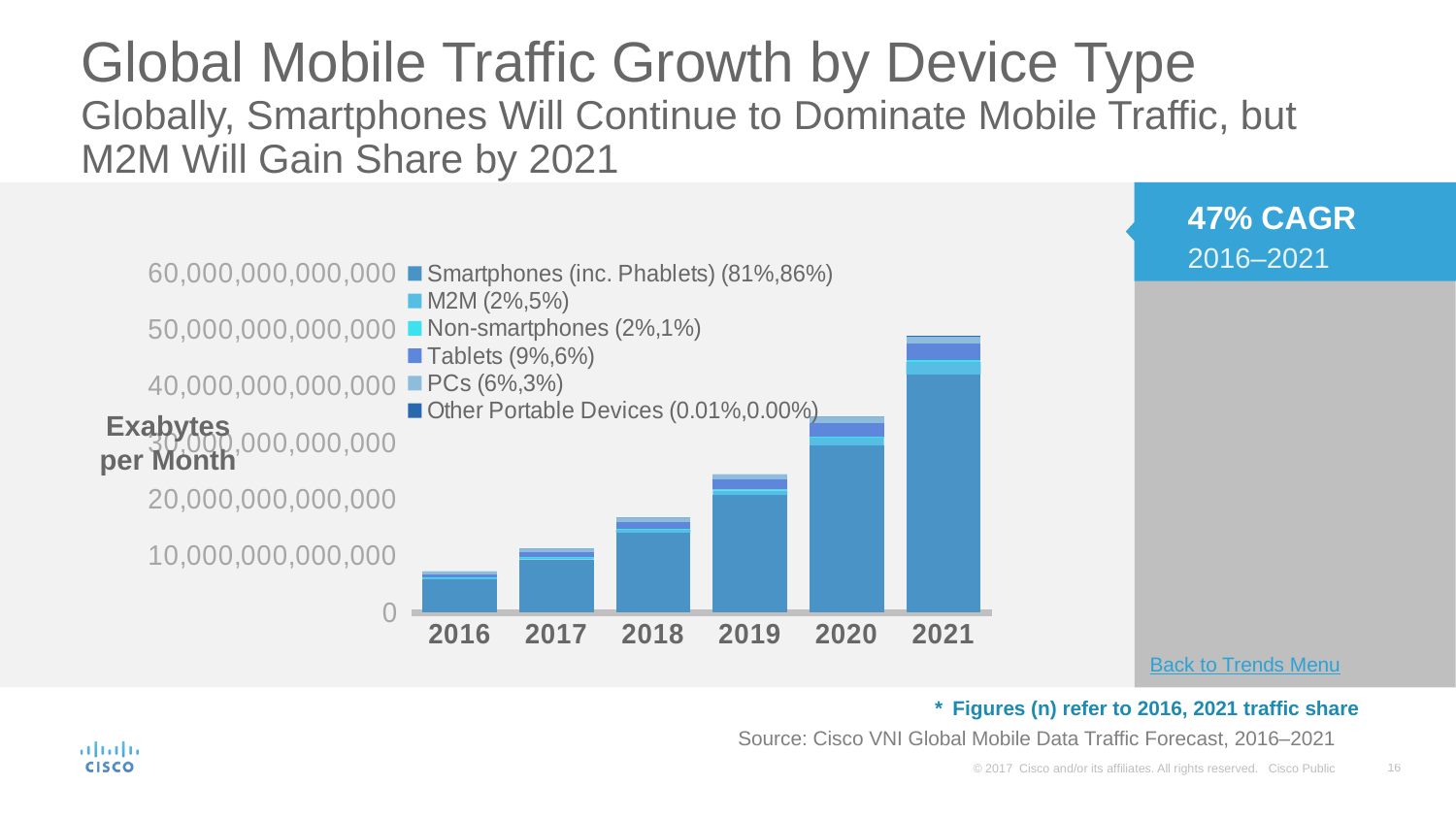
Which year has the shortest bar in the chart? 2016 What CAGR for 2016–2021 is stated on the slide? 47% CAGR Is the total bar height for 2016 greater or less than 10,000,000,000,000? less Is the total bar height for 2021 greater or less than 40,000,000,000,000? greater What kind of chart is shown on the slide? Stacked bar chart Do the total bar heights rise or fall from 2016 to 2021? Rise Which year has the tallest bar in the chart? 2021 Which year has the taller bar, 2018 or 2020? 2020 How many series does the chart's legend list? 6 Is the total bar height for 2020 greater or less than 30,000,000,000,000? greater How many years are shown along the x axis of the chart? 6 According to the legend, what traffic share do Smartphones (inc. Phablets) have in 2021? 86%